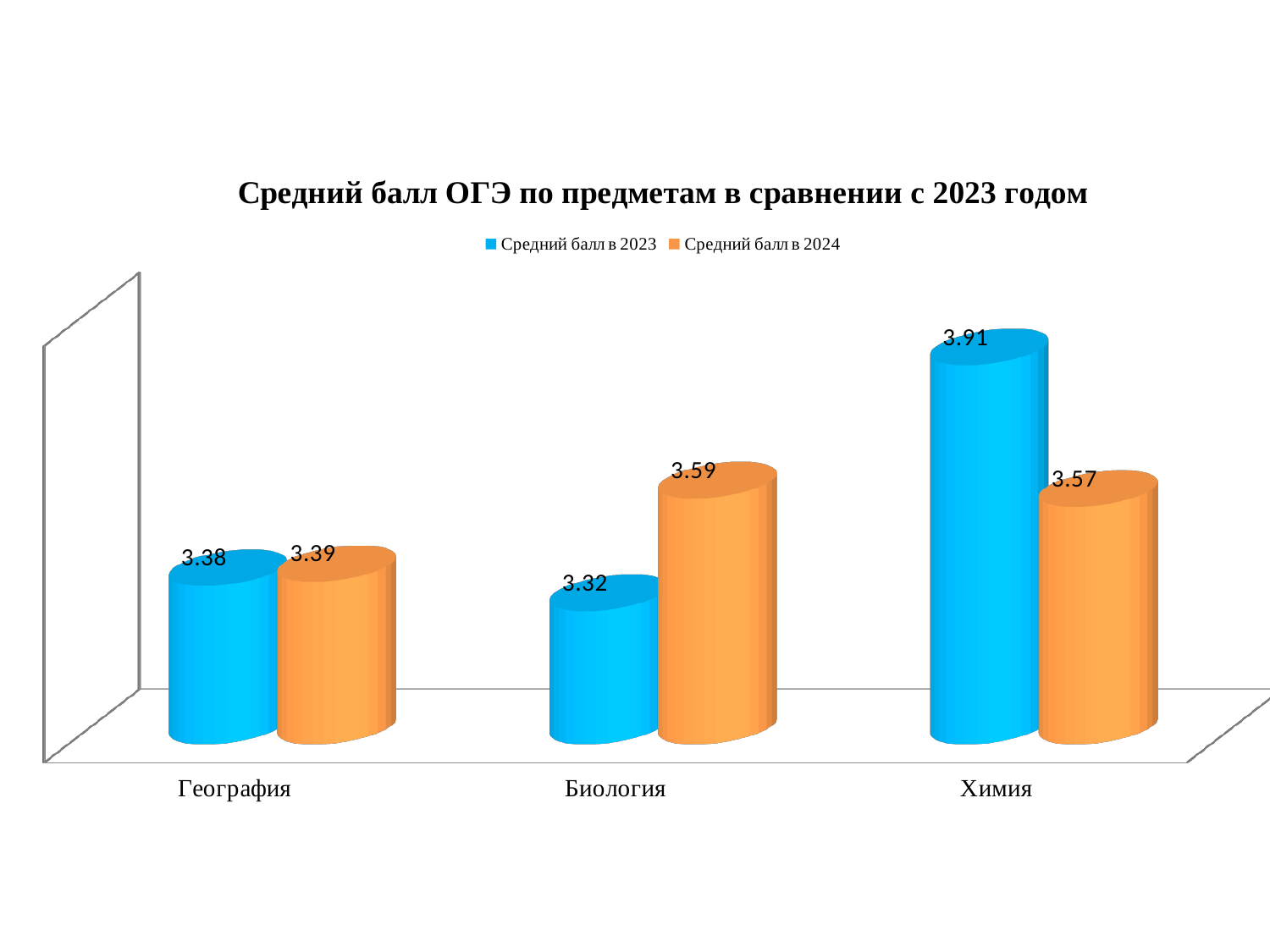
What is the value of the 'Средний балл в 2023' series for География? 3.38 What is the average score in 2024 for Биология? 3.59 For Химия, which is larger: the average score in 2023 or in 2024? 2023 How many series does the legend list? 2 Which subject has the lowest average score in 2024? География What type of chart is shown on the slide? Bar chart Which subject has the lowest average score in 2023? Биология What is the value of the 'Средний балл в 2024' series for Химия? 3.57 What is the average score in 2023 for Химия? 3.91 How many subjects are shown on the x axis? 3 What is the difference between the 2024 and 2023 average scores for Биология? 0.27 Which subject has the highest average score in 2023? Химия